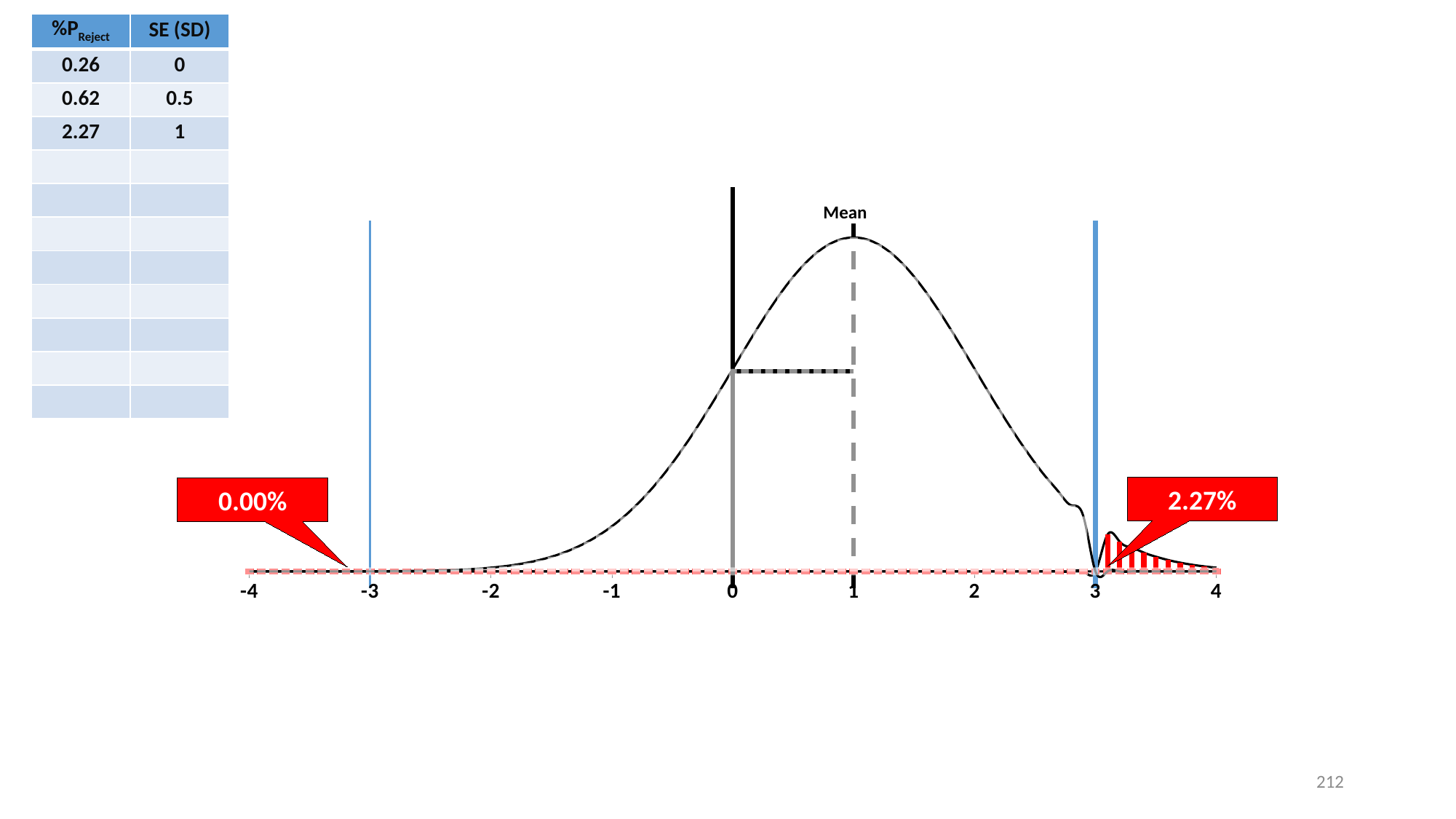
At which two x-axis values are the blue vertical lines drawn? -3 and 3 What is the difference between the right-tail callout percentage and the left-tail callout percentage? 2.27% At which x-axis value is the solid black vertical line drawn? 0 At which x-axis value is the 'Mean' label placed? 1 Which tail of the curve has the larger percentage in its callout, the left or the right? right What percentage is shown in the callout pointing to the left tail of the curve? 0.00% What percentage is shown in the callout pointing to the right tail of the curve? 2.27% What kind of chart is shown on the slide? line chart Is the right-tail callout percentage greater or less than 2%? greater What is the range of the x axis, from its lowest to its highest tick label? -4 to 4 How many tick labels are shown on the x axis? 9